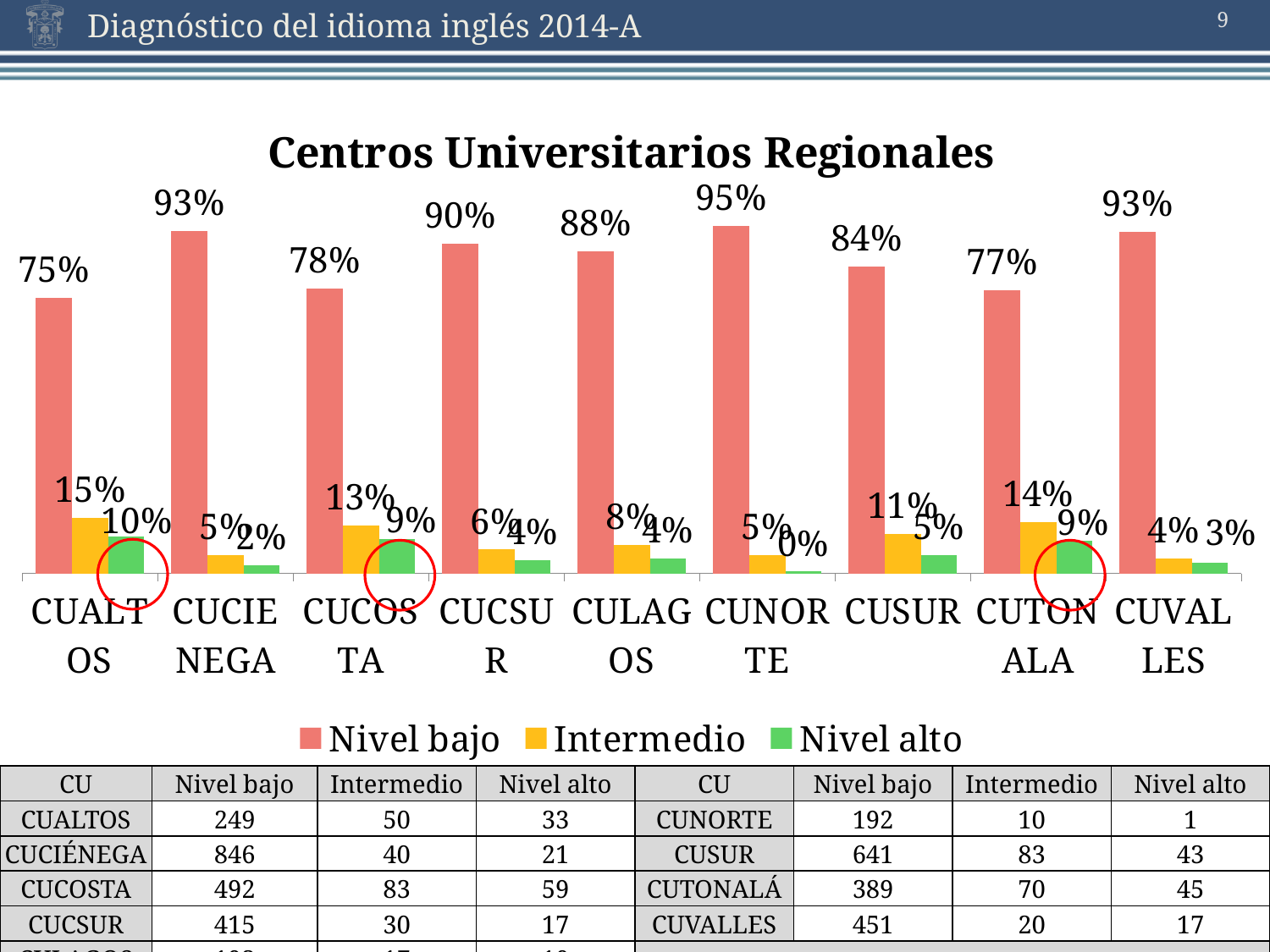
What is the Intermedio value for CUALTOS? 15% Which is larger, the Intermedio value for CUTONALA or for CUSUR? CUTONALA How many centros universitarios are shown on the x axis of the chart? 9 Which centro universitario has the lowest Nivel alto value? CUNORTE Which centro universitario has the highest Nivel bajo value? CUNORTE What is the Nivel bajo value for CUNORTE? 95% What is the title of the chart? Centros Universitarios Regionales How many series does the legend list? 3 What is the difference between the Nivel bajo values of CUCIENEGA and CUALTOS? 18% Which centro universitario has the lowest Nivel bajo value? CUALTOS What is the Nivel alto value for CUCOSTA? 9% What kind of chart is shown on the slide? Bar chart